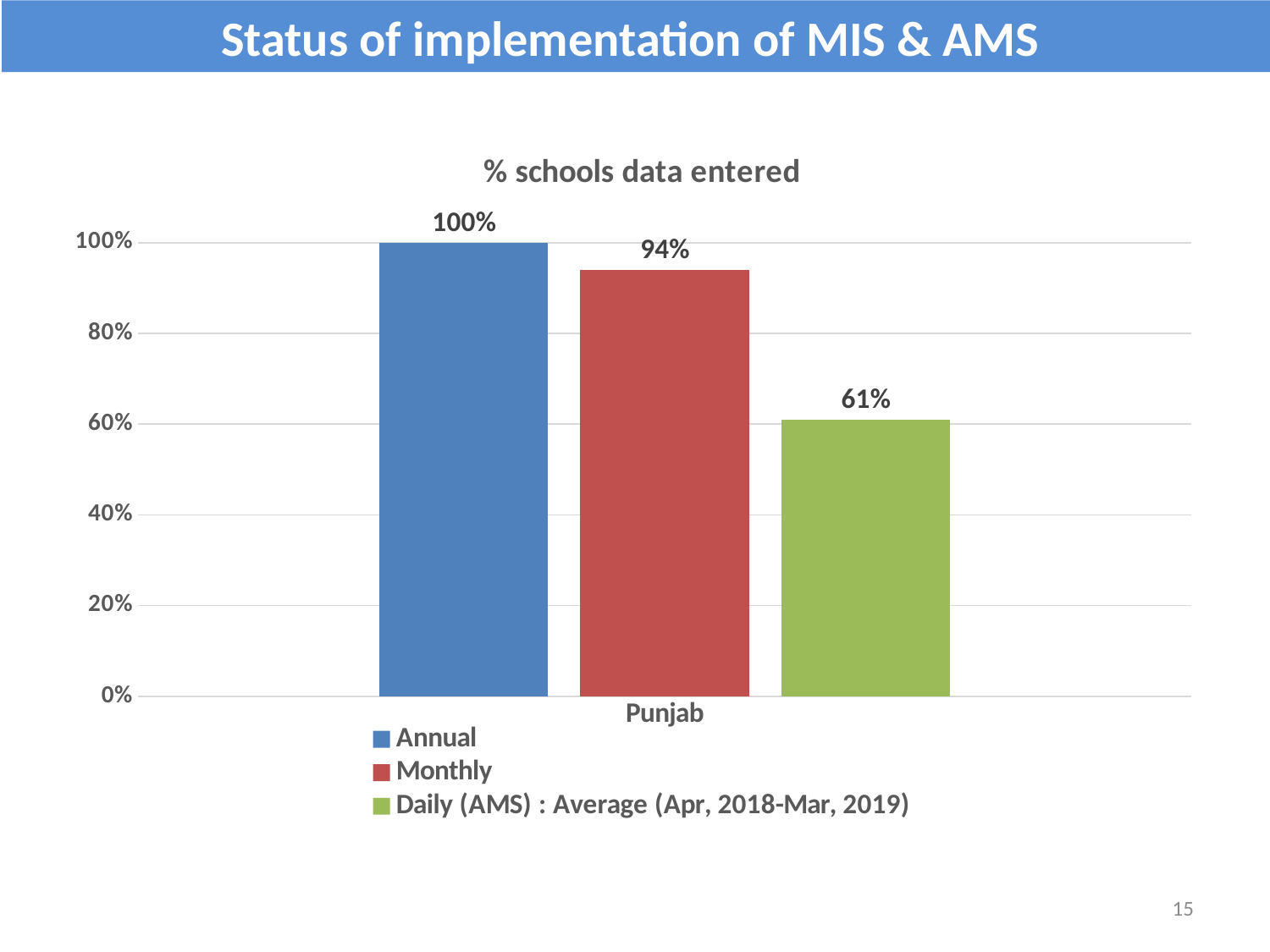
How many series does the legend list? 3 What is the difference between the Monthly and Daily (AMS) values for Punjab? 33% What is the value for the Monthly series for Punjab? 94% Is the Daily (AMS) value for Punjab greater or less than 80%? less Which is larger for Punjab, the Monthly value or the Daily (AMS) value? Monthly What is the difference between the Annual and Monthly values for Punjab? 6% What is the value for the Daily (AMS) : Average (Apr, 2018-Mar, 2019) series for Punjab? 61% Which series has the lowest value for Punjab? Daily (AMS) : Average (Apr, 2018-Mar, 2019) What is the value for the Annual series for Punjab? 100% What kind of chart is shown on the slide? bar chart Which series has the highest value for Punjab? Annual What is the title of the chart? % schools data entered